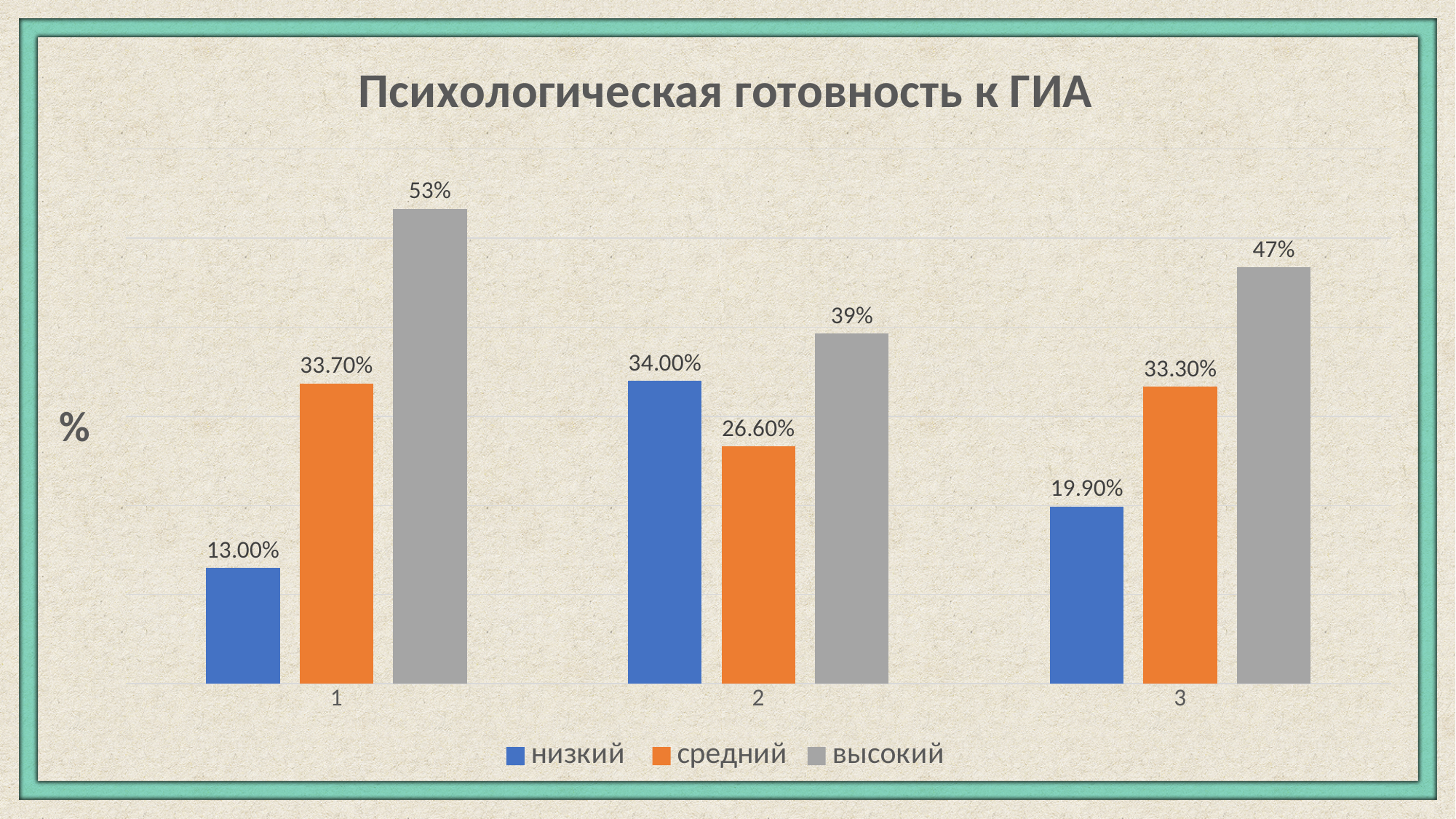
What is the value of the 'низкий' series for category 1? 13.00% What kind of chart is shown on the slide? bar chart Which category has the highest value for the 'высокий' series? 1 What is the value of the 'средний' series for category 3? 33.30% Which category has the lowest value for the 'низкий' series? 1 What is the difference between the 'высокий' values for category 1 and category 3? 6% What is the title of the chart? Психологическая готовность к ГИА How many series does the legend list? 3 What is the value of the 'низкий' series for category 2? 34.00% Which is larger for category 2: the 'низкий' value or the 'средний' value? низкий How many categories are shown on the x axis? 3 What is the value of the 'высокий' series for category 2? 39%